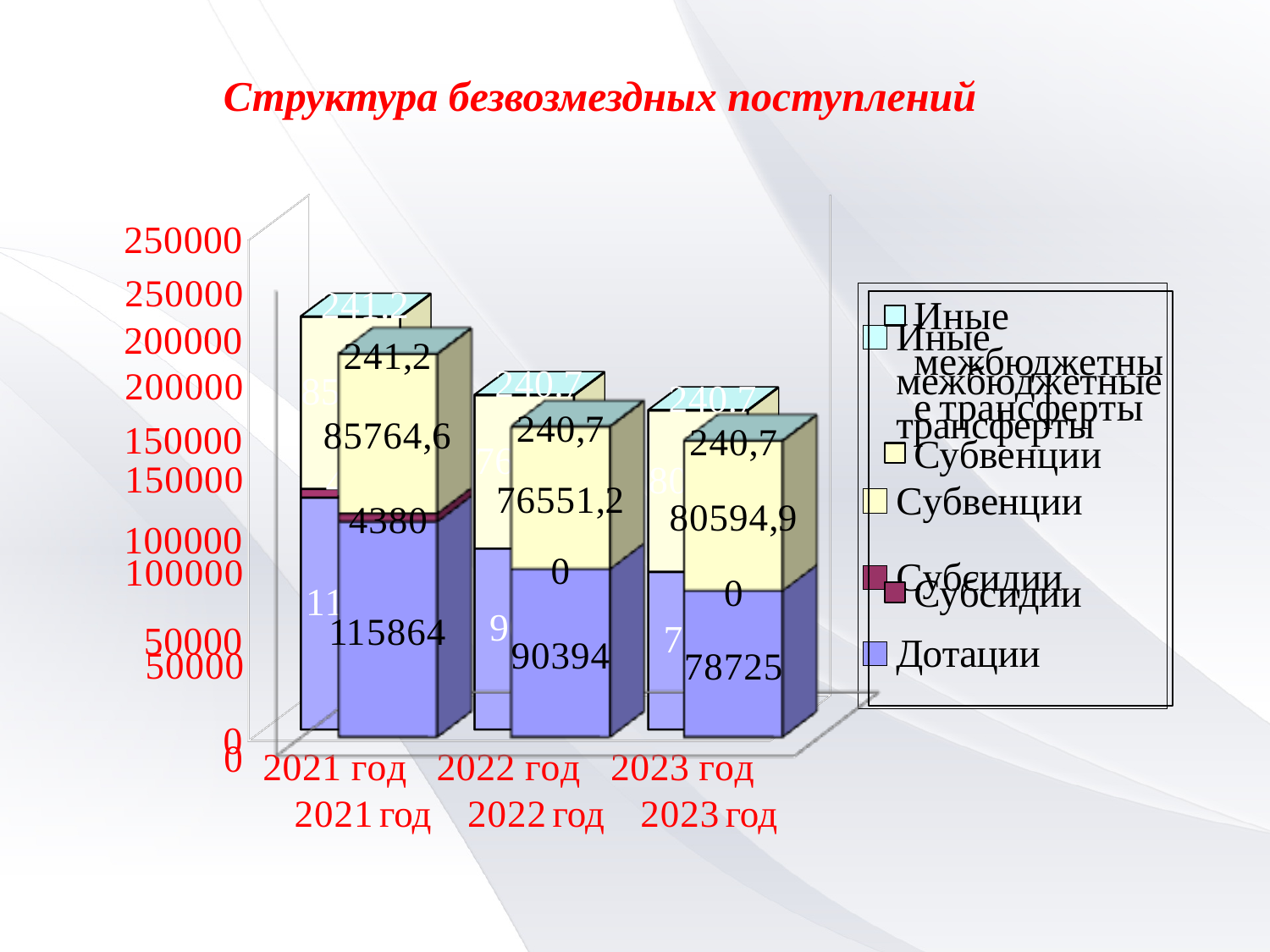
What is the value of Субсидии for 2021 год? 4380 How many series does the legend list? 4 Which year has the lowest value for Субвенции? 2022 год What is the value of Субвенции for 2023 год? 80594,9 What is the value of Иные межбюджетные трансферты for 2022 год? 240,7 What is the value of Дотации for 2021 год? 115864 How many years are shown on the x axis? 3 What is the difference between Дотации in 2021 год and 2022 год? 25470 Which is larger in 2023 год: Дотации or Субвенции? Субвенции Which year has the highest value for Дотации? 2021 год What kind of chart is shown on the slide? Stacked bar chart What is the total of the stacked bar for 2022 год? 167185,9